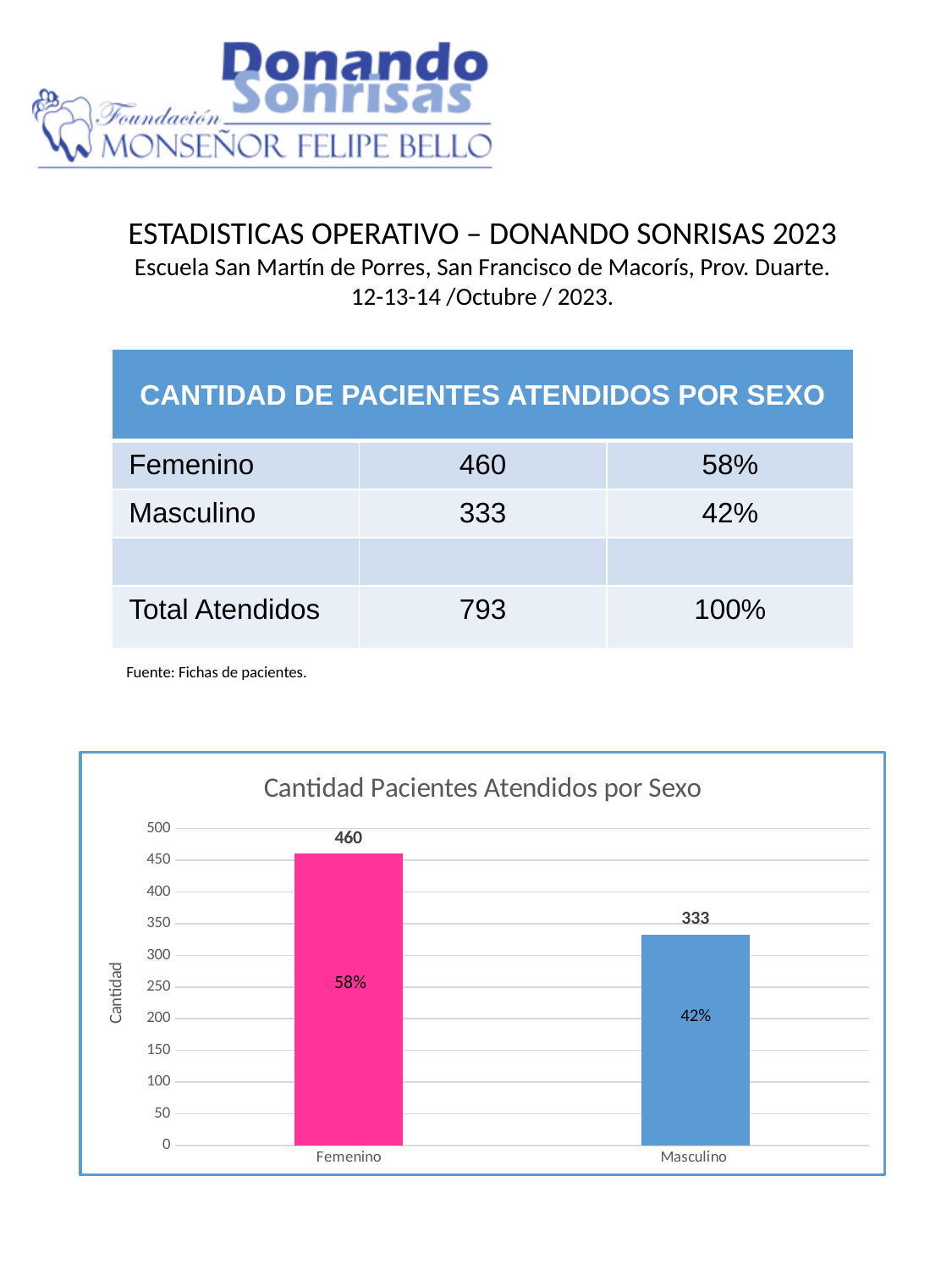
What kind of chart is shown on the slide? bar chart Which category has the highest value in the chart? Femenino What is the title of the chart? Cantidad Pacientes Atendidos por Sexo What is the value for Masculino in the chart? 333 Which category has the lowest value in the chart? Masculino What percentage label is shown inside the Femenino bar? 58% Is the value for Masculino greater or less than 350? less What is the difference between the values for Femenino and Masculino? 127 How many categories are shown in the chart? 2 What is the label of the vertical axis of the chart? Cantidad What is the value for Femenino in the chart? 460 Which is larger, the value for Femenino or the value for Masculino? Femenino